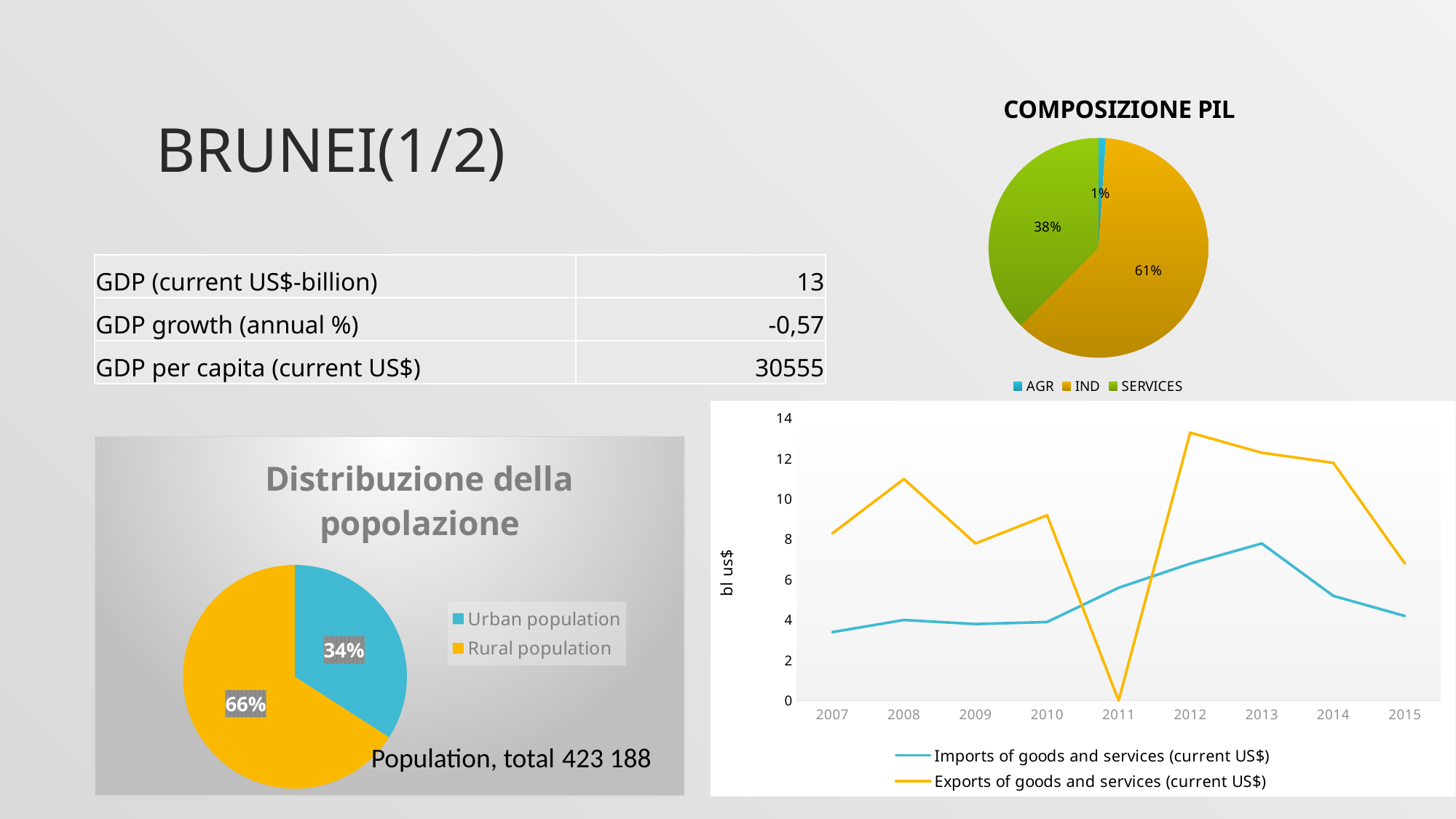
In the COMPOSIZIONE PIL pie chart, what share does SERVICES have? 38% In the bottom-right line chart, how many years are shown on the x axis? 9 In the bottom-right line chart, is the value for Imports of goods and services in 2007 greater or less than 4? less How many series does the legend of the Distribuzione della popolazione chart list? 2 In the bottom-right line chart, is the value for Exports of goods and services in 2012 greater or less than 12? greater What kind of chart is the chart at the bottom right of the slide? Line chart In the COMPOSIZIONE PIL pie chart, what share does IND have? 61% In the COMPOSIZIONE PIL pie chart, what is the difference in percentage points between IND and SERVICES? 23 In the Distribuzione della popolazione pie chart, which is larger, Urban population or Rural population? Rural population In the COMPOSIZIONE PIL pie chart, which sector has the smallest share? AGR In the bottom-right line chart, which series is higher in 2011, Imports or Exports of goods and services? Imports of goods and services (current US$) In the Distribuzione della popolazione pie chart, what share is Rural population? 66%